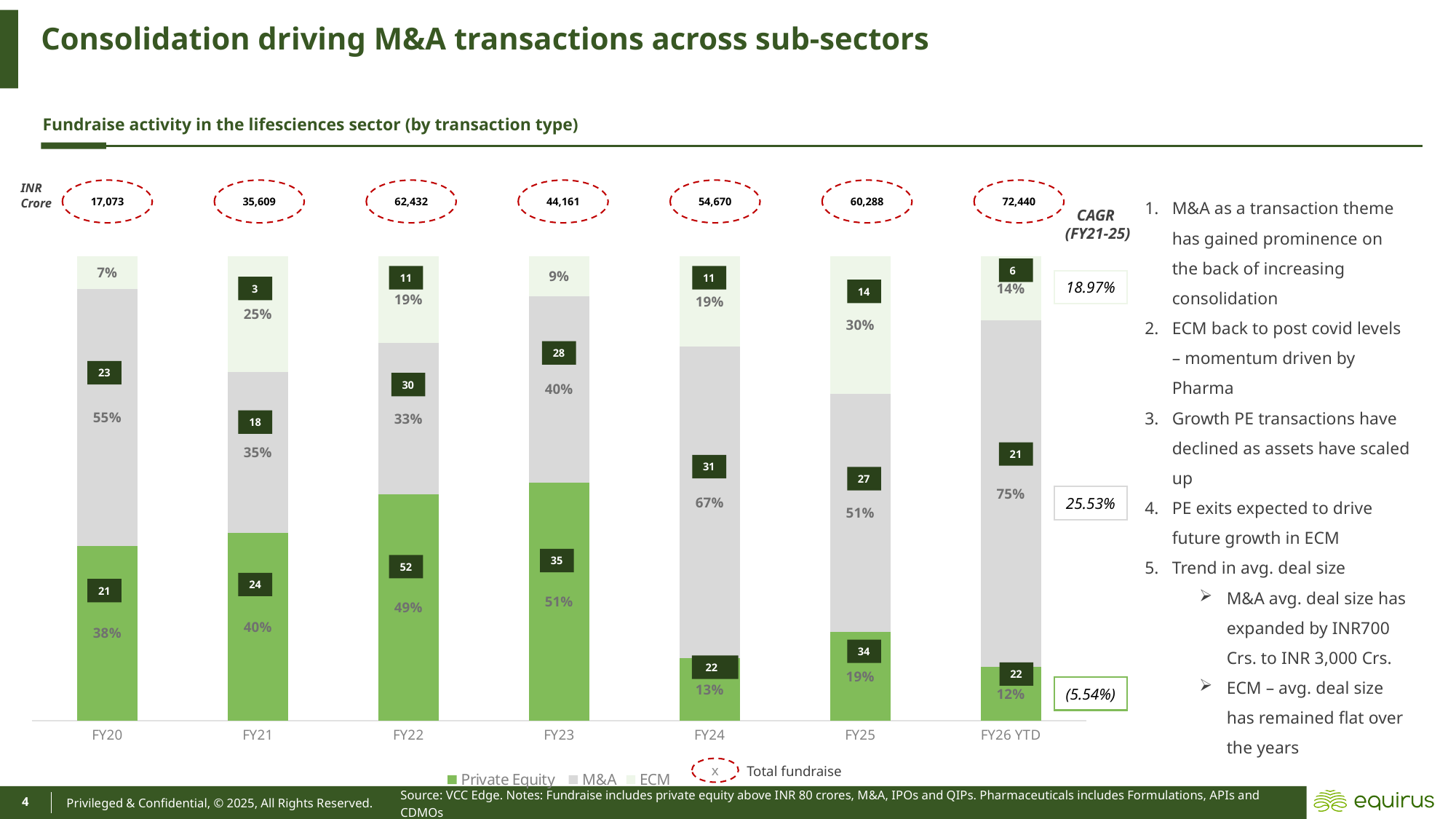
How many fiscal-year categories are shown on the x axis of the chart? 7 Which fiscal year has the highest total fundraise value? FY26 YTD What is the M&A share of fundraise activity in FY24? 67% What is the total fundraise (INR Crore) shown for FY22? 62,432 What CAGR (FY21-25) is shown next to the M&A segment? 25.53% What is the ECM share of fundraise activity in FY25? 30% Which fiscal year has the lowest total fundraise value? FY20 How does the Private Equity share change from FY23 to FY26 YTD? It falls Which year has the larger Private Equity share: FY23 or FY24? FY23 How many series does the chart legend list? 3 By how much does the total fundraise for FY26 YTD exceed that of FY25? 12,152 What kind of chart is shown on the slide? Stacked bar chart